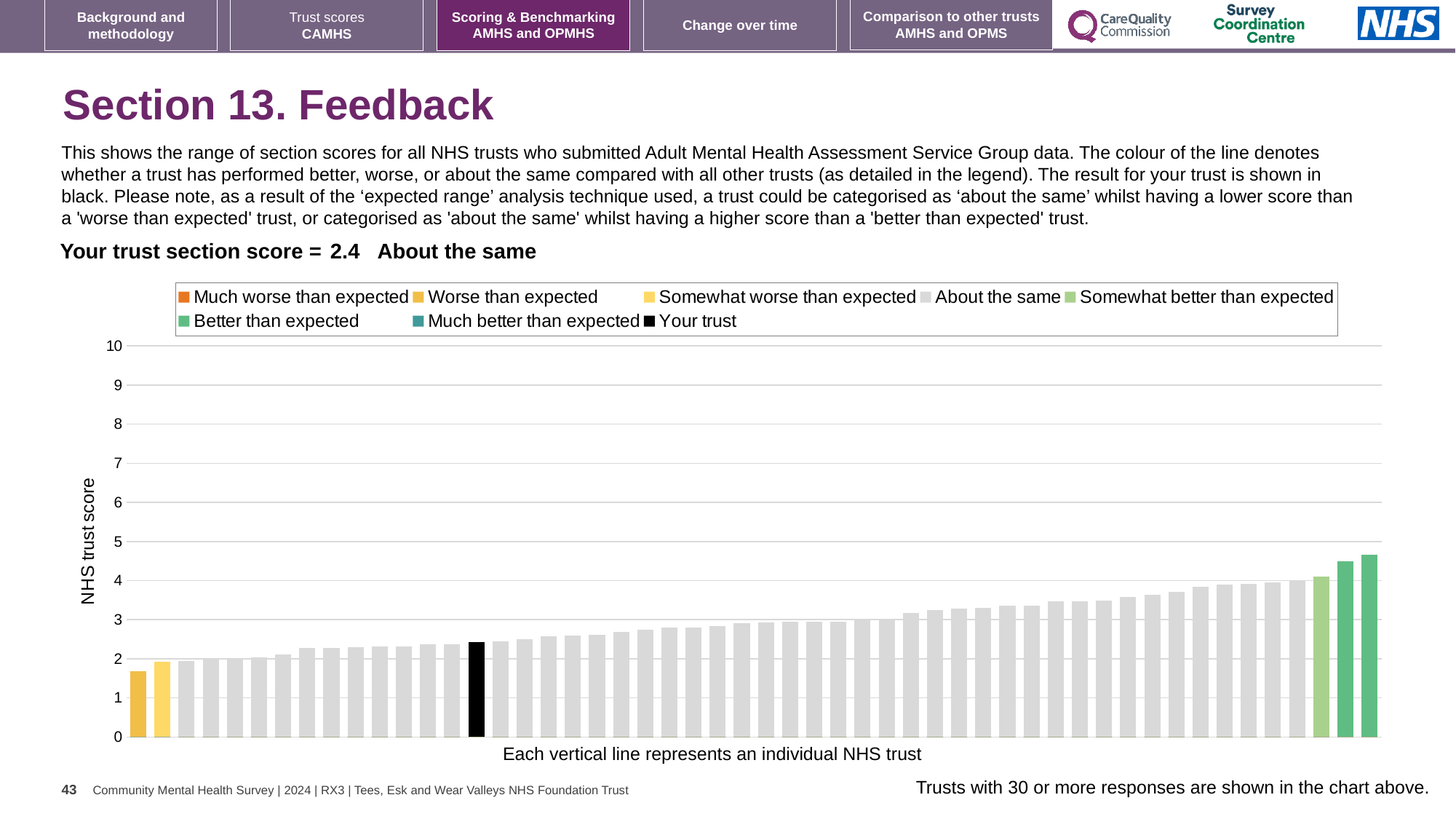
What kind of chart is shown on the slide? bar chart Is the value of the tallest bar in the chart greater or less than 4? greater How many entries does the chart legend list? 8 Is the value for your trust (the black bar) greater or less than 5? less Is the value of the leftmost bar in the chart greater or less than 2? less What is the section score for your trust shown on the slide? 2.4 Do the bar values rise or fall from left to right across the chart? rise What is the label on the vertical axis of the chart? NHS trust score Which is larger, the leftmost bar or the rightmost bar? the rightmost bar What colour is the bar representing your trust? black